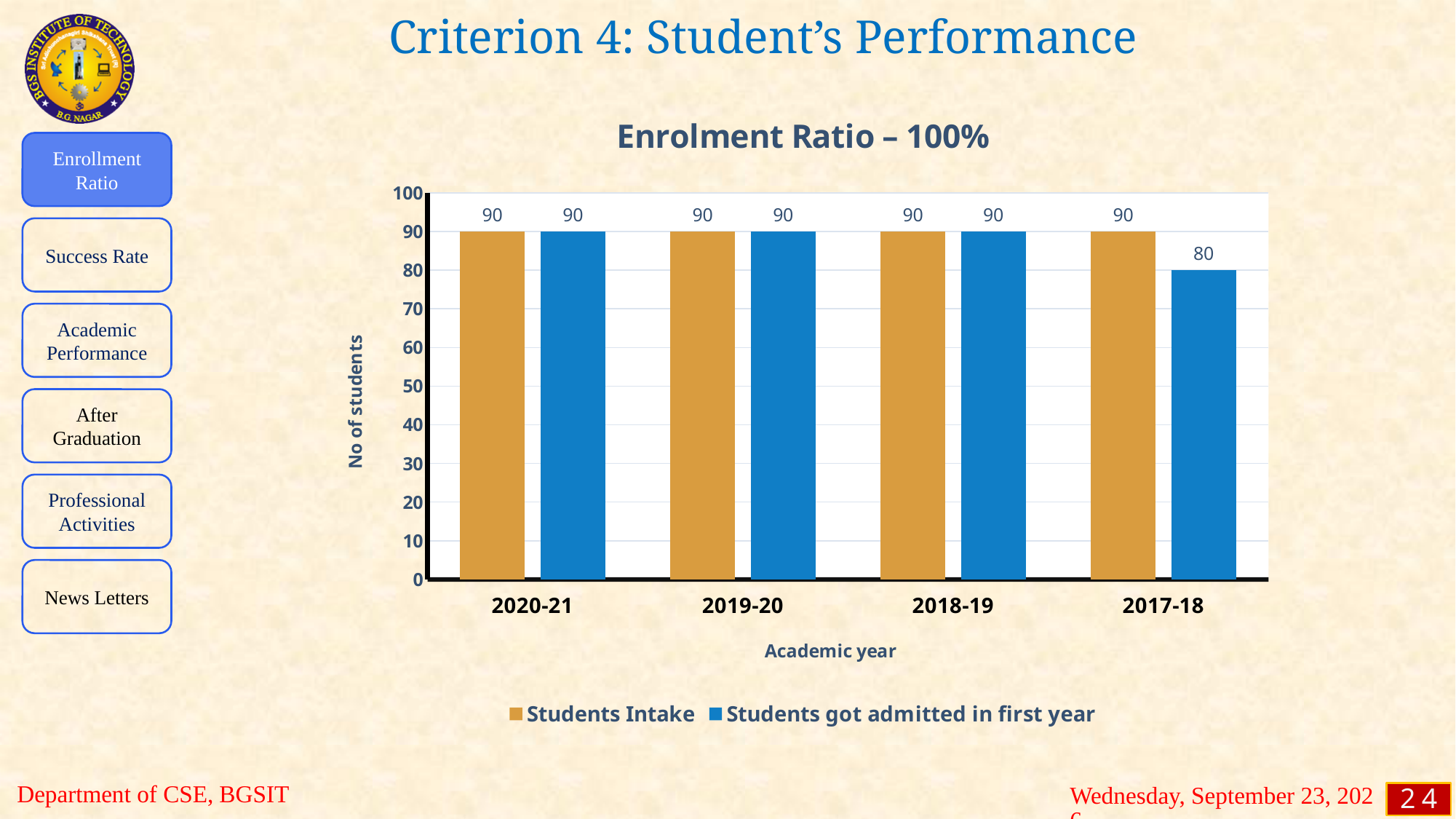
What is the difference between Students Intake and Students got admitted in first year for 2017-18? 10 How many series does the legend list? 2 How many academic years are shown on the x axis? 4 What is the value of Students Intake for 2020-21? 90 Is the value for Students got admitted in first year in 2017-18 greater or less than 90? less What is the value of Students got admitted in first year for 2017-18? 80 What kind of chart is shown on the slide? bar chart Which academic year has the lowest value for Students got admitted in first year? 2017-18 What is the value of Students got admitted in first year for 2019-20? 90 What is the title of the chart? Enrolment Ratio – 100% For 2017-18, which is larger: Students Intake or Students got admitted in first year? Students Intake What is the label of the y axis? No of students